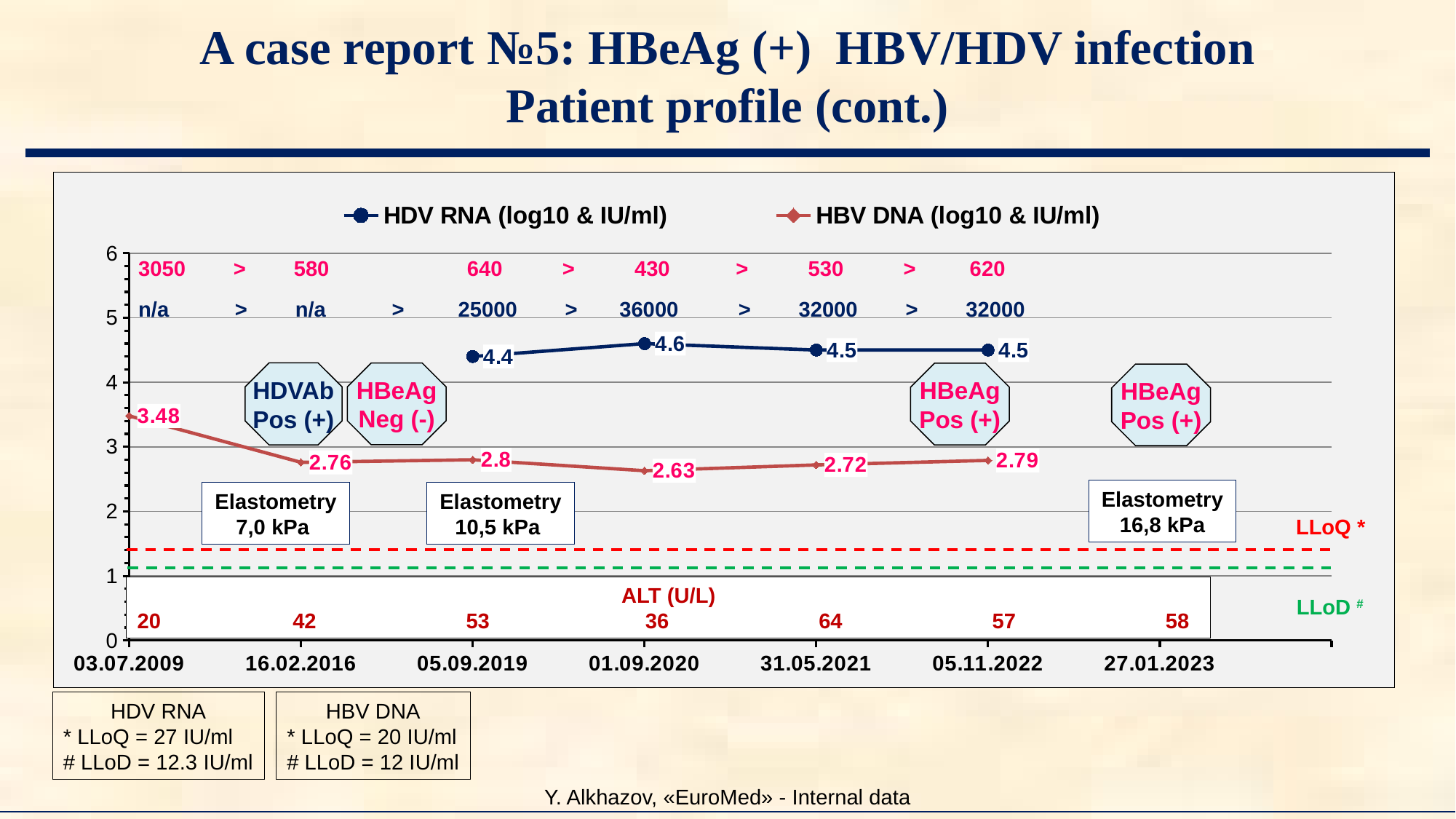
What is the HBV DNA (log10) value on 05.11.2022? 2.79 How many data points are plotted for the HDV RNA series? 4 On 05.09.2019, which is larger: the HDV RNA value or the HBV DNA value? HDV RNA On which date is the HBV DNA (log10) value lowest? 01.09.2020 What is the HDV RNA (log10) value on 01.09.2020? 4.6 What kind of chart is shown on the slide? line chart Does the HBV DNA (log10) value rise or fall from 03.07.2009 to 16.02.2016? fall What is the HBV DNA (log10) value on 03.07.2009? 3.48 On which date is the HBV DNA (log10) value highest? 03.07.2009 How many series does the chart legend list? 2 On which date is the HDV RNA (log10) value highest? 01.09.2020 What is the difference between the HBV DNA (log10) values on 03.07.2009 and 16.02.2016? 0.72